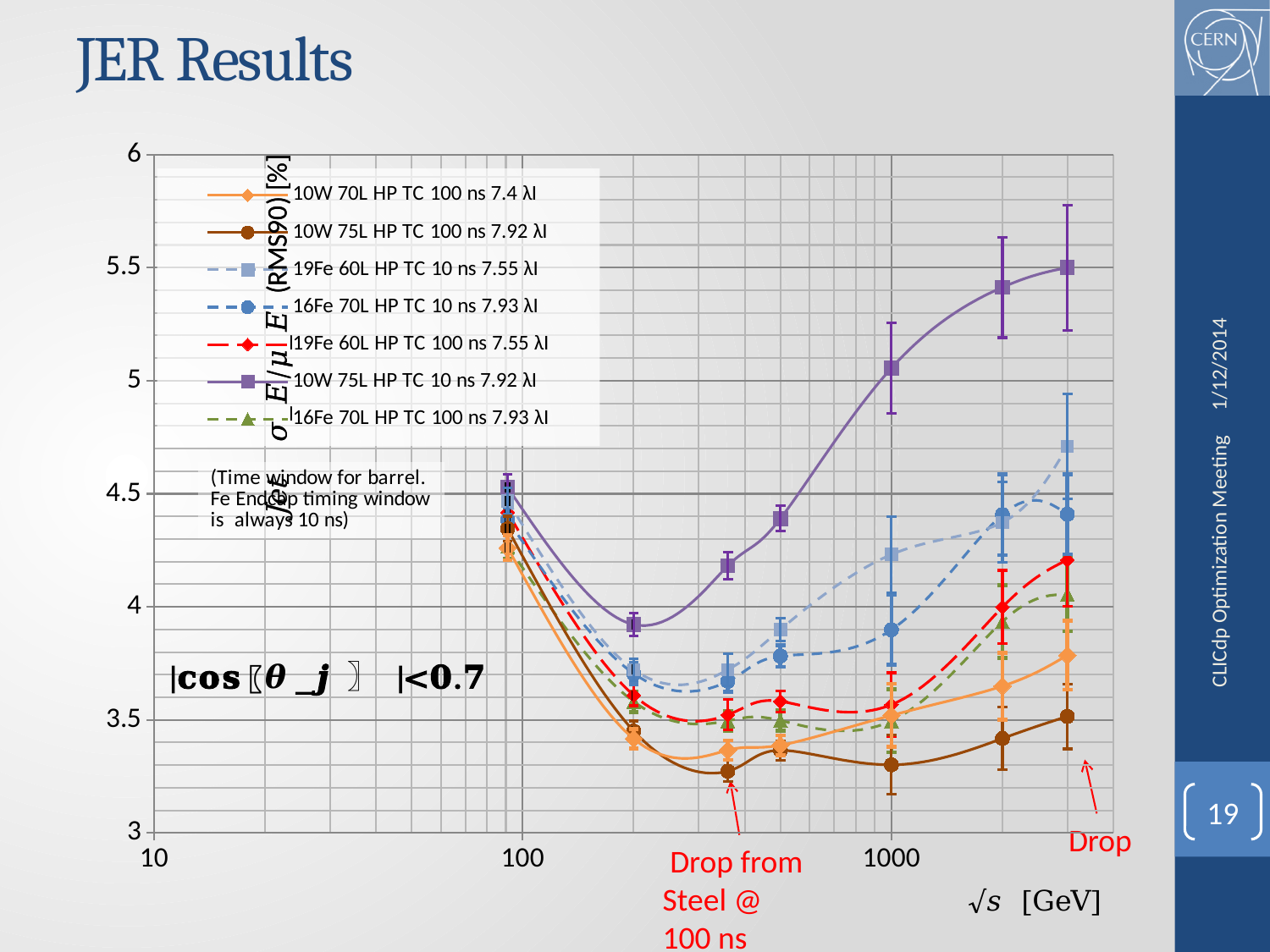
Is the value for the 10W 75L HP TC 100 ns 7.92 λI series at 1000 GeV greater or less than 3.5? less What is the title of the slide containing the chart? JER Results Is the value for the 10W 75L HP TC 10 ns 7.92 λI series at about 2000 GeV greater or less than 5? greater What is the label of the x axis? √s [GeV] Which series has the lowest value at the rightmost data point (around 3000 GeV)? 10W 75L HP TC 100 ns 7.92 λI How many data points are plotted for the 10W 75L HP TC 10 ns 7.92 λI series? 7 How many series does the legend list? 7 Does the 10W 75L HP TC 10 ns 7.92 λI series rise or fall between about 200 GeV and 3000 GeV? rise Is the value for the 19Fe 60L HP TC 10 ns 7.55 λI series at the rightmost point greater or less than 4.5? greater At 1000 GeV, which series has the larger value: 10W 75L HP TC 10 ns 7.92 λI or 16Fe 70L HP TC 10 ns 7.93 λI? 10W 75L HP TC 10 ns 7.92 λI What kind of chart is shown on the slide? line chart Which series has the highest value at the rightmost data point (around 3000 GeV)? 10W 75L HP TC 10 ns 7.92 λI